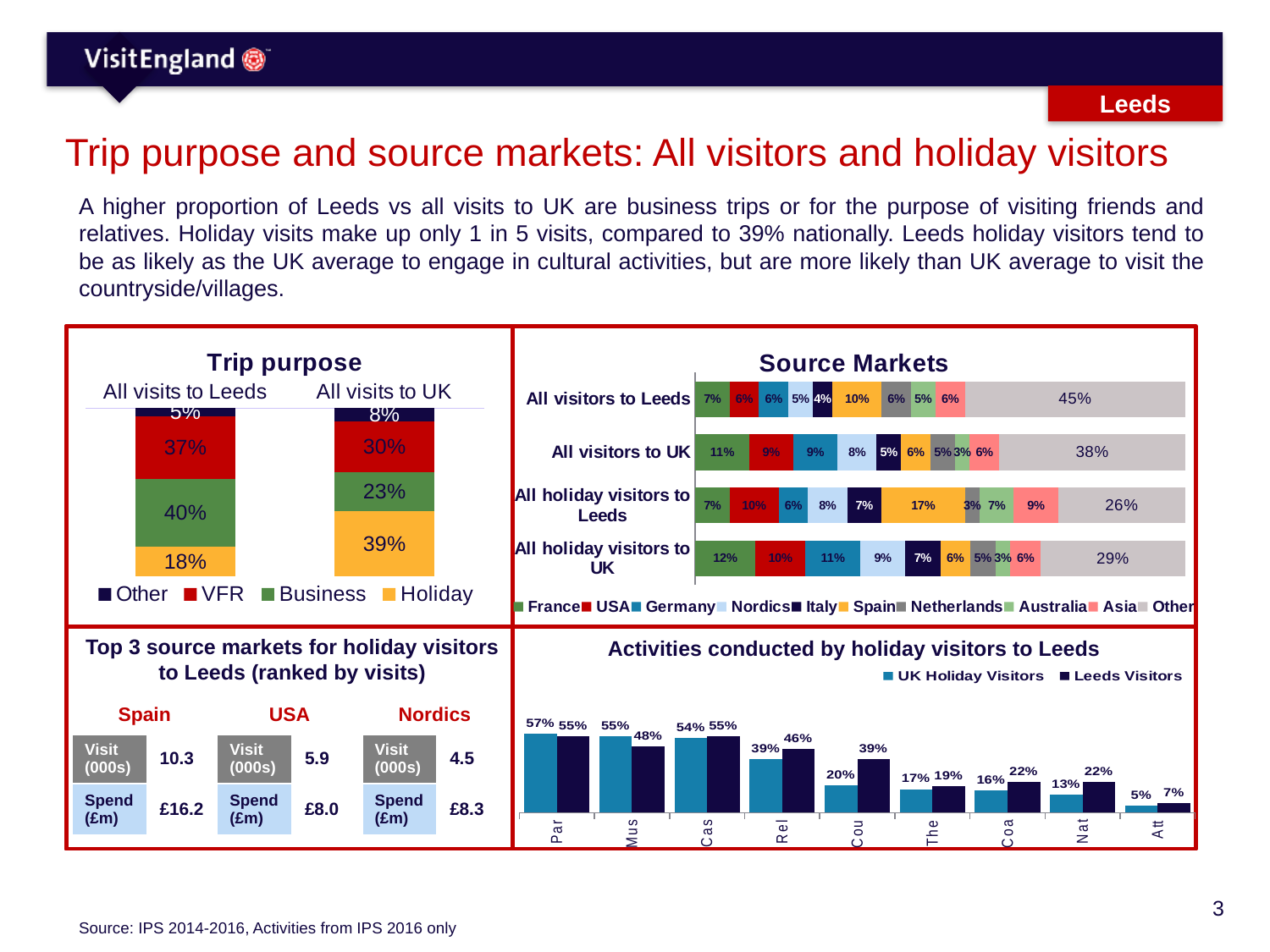
In the Trip purpose chart, what is the difference between the VFR share for all visits to Leeds and the VFR share for all visits to the UK? 7% In the Trip purpose chart, what percentage of all visits to the UK are Holiday trips? 39% In the Trip purpose chart, which is larger: the Holiday share for all visits to Leeds or the Holiday share for all visits to the UK? All visits to UK How many series does the legend of the Source Markets chart list? 10 In the Source Markets chart, what is the 'Other' share for all visitors to Leeds? 45% How many categories (bars) are shown in the Source Markets chart? 4 How many series does the legend of the Trip purpose chart list? 4 In the Activities conducted by holiday visitors to Leeds chart, what is the value for Leeds Visitors in the fifth category (labelled 'Cou')? 39% In the Trip purpose chart, what percentage of all visits to Leeds are Business trips? 40% In the Source Markets chart, what percentage of all holiday visitors to Leeds come from Spain? 17% What kind of chart is the Activities conducted by holiday visitors to Leeds chart? Bar chart In the Source Markets chart, what percentage of all visitors to Leeds come from Spain? 10%